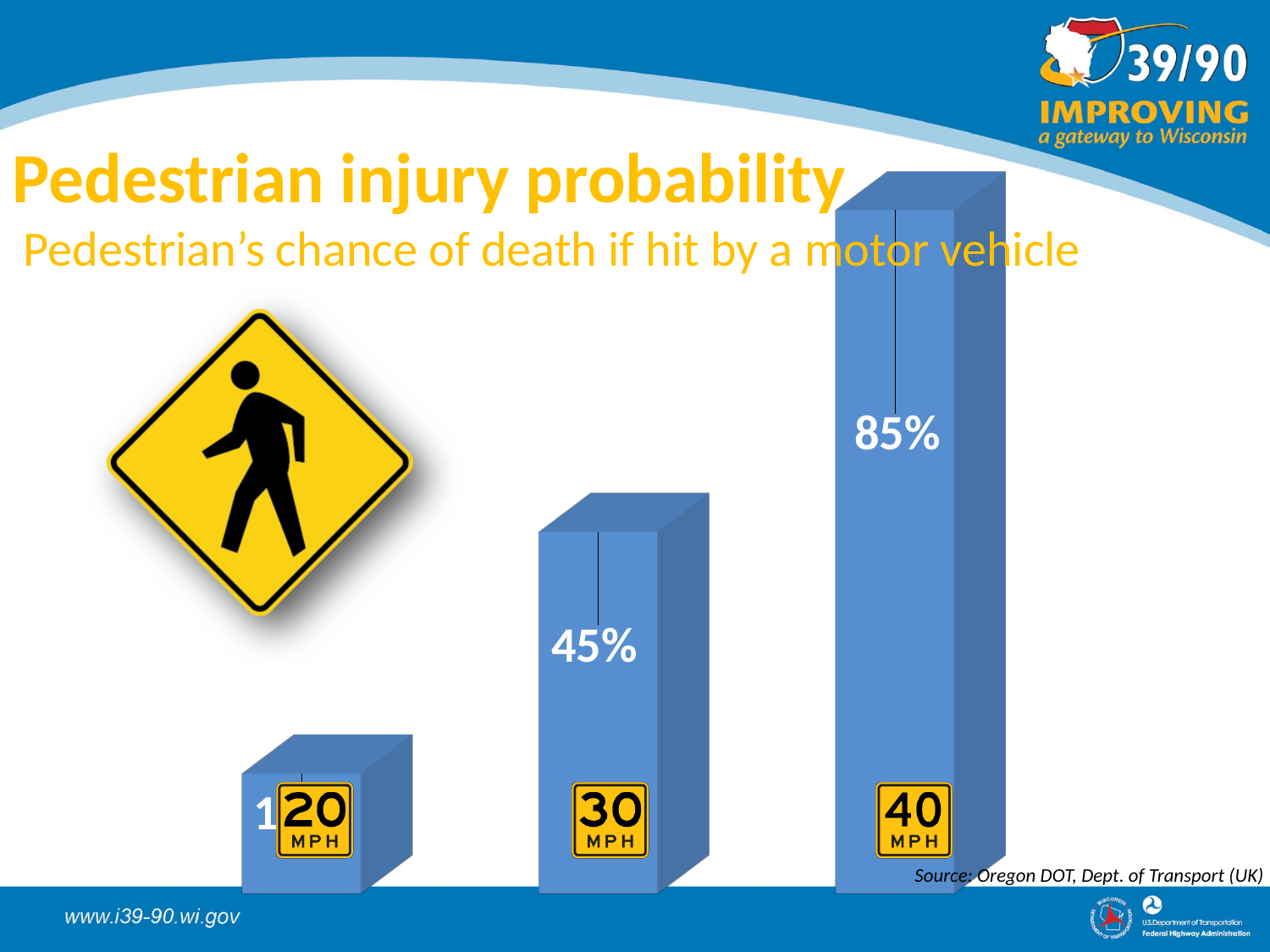
How much higher is the chance of death at 40 MPH than at 30 MPH? 40% What is the pedestrian's chance of death if hit at 30 MPH? 45% How many speed categories are shown in the chart? 3 What is the pedestrian's chance of death if hit at 40 MPH? 85% What kind of chart is shown on the slide? Bar chart Which speed has the lowest chance of pedestrian death? 20 MPH Which speed has the highest chance of pedestrian death? 40 MPH What source is cited for the chart data? Oregon DOT, Dept. of Transport (UK) Do the values rise or fall as the speed increases from 20 MPH to 40 MPH? Rise Which is larger, the chance of death at 30 MPH or at 40 MPH? 40 MPH What is the title of the slide? Pedestrian injury probability